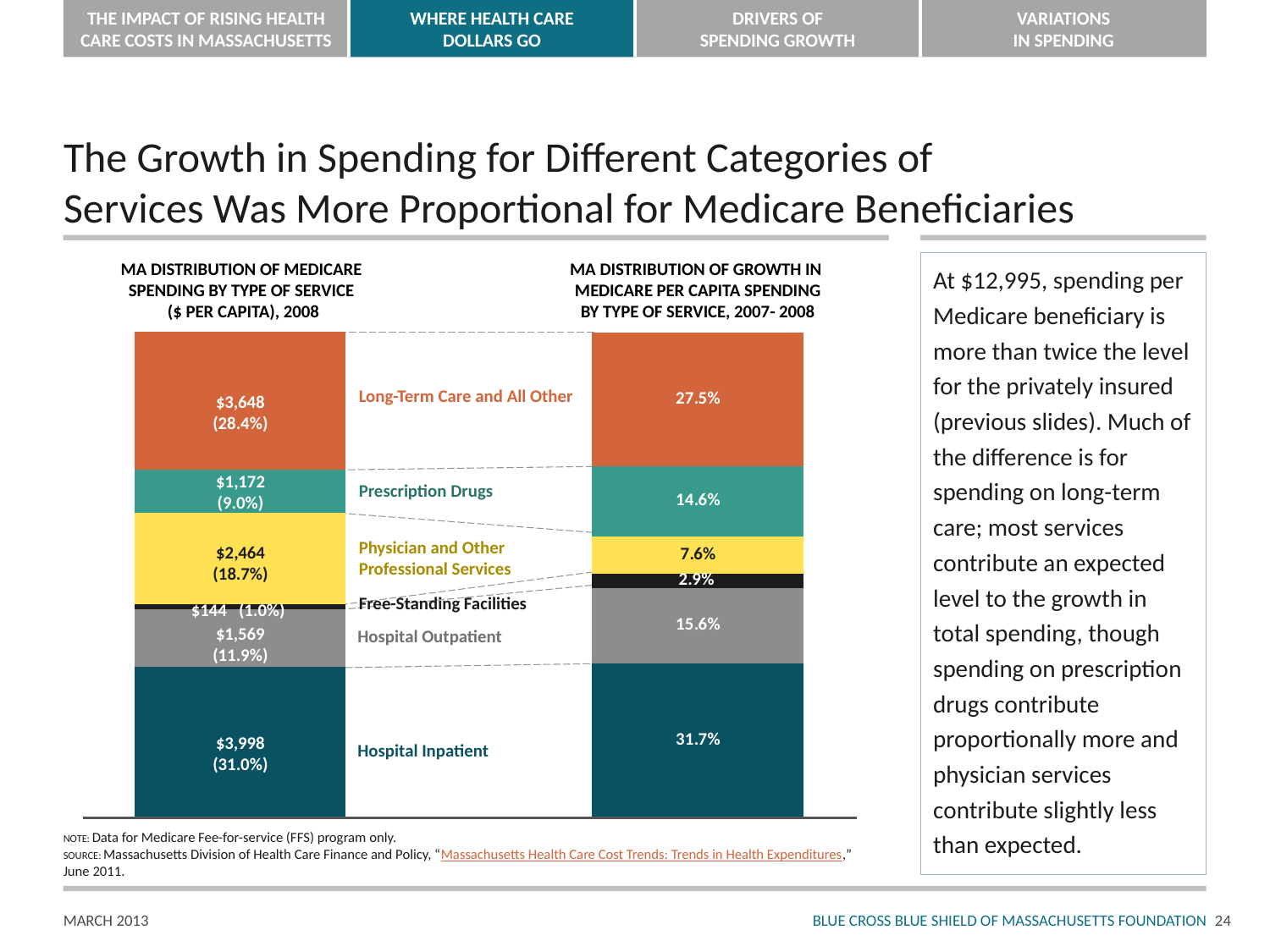
In the left chart (MA Distribution of Medicare Spending by Type of Service, 2008), what is the total per capita spending across all types of service? $12,995 In the right chart (MA Distribution of Growth in Medicare Per Capita Spending, 2007-2008), what share of growth is attributed to Long-Term Care and All Other? 27.5% In the right chart (MA Distribution of Growth in Medicare Per Capita Spending, 2007-2008), what share of growth is attributed to Physician and Other Professional Services? 7.6% In the left chart (MA Distribution of Medicare Spending by Type of Service, 2008), what is the per capita spending for Hospital Inpatient? $3,998 In the left chart (MA Distribution of Medicare Spending by Type of Service, 2008), which type of service has the highest per capita spending? Hospital Inpatient In the left chart (MA Distribution of Medicare Spending by Type of Service, 2008), what is the per capita spending for Free-Standing Facilities? $144 In the left chart (MA Distribution of Medicare Spending by Type of Service, 2008), what is the difference in per capita spending between Hospital Inpatient and Long-Term Care and All Other? $350 In the left chart (MA Distribution of Medicare Spending by Type of Service, 2008), what share of spending is Prescription Drugs? 9.0% In the right chart (MA Distribution of Growth in Medicare Per Capita Spending, 2007-2008), which type of service contributes the smallest share of growth? Free-Standing Facilities What kind of chart is used on the slide to show the distribution of Medicare spending? Stacked bar chart How many types of service are shown in each stacked bar on the slide? 6 In the right chart (MA Distribution of Growth in Medicare Per Capita Spending, 2007-2008), which contributes a larger share of growth: Prescription Drugs or Hospital Outpatient? Hospital Outpatient